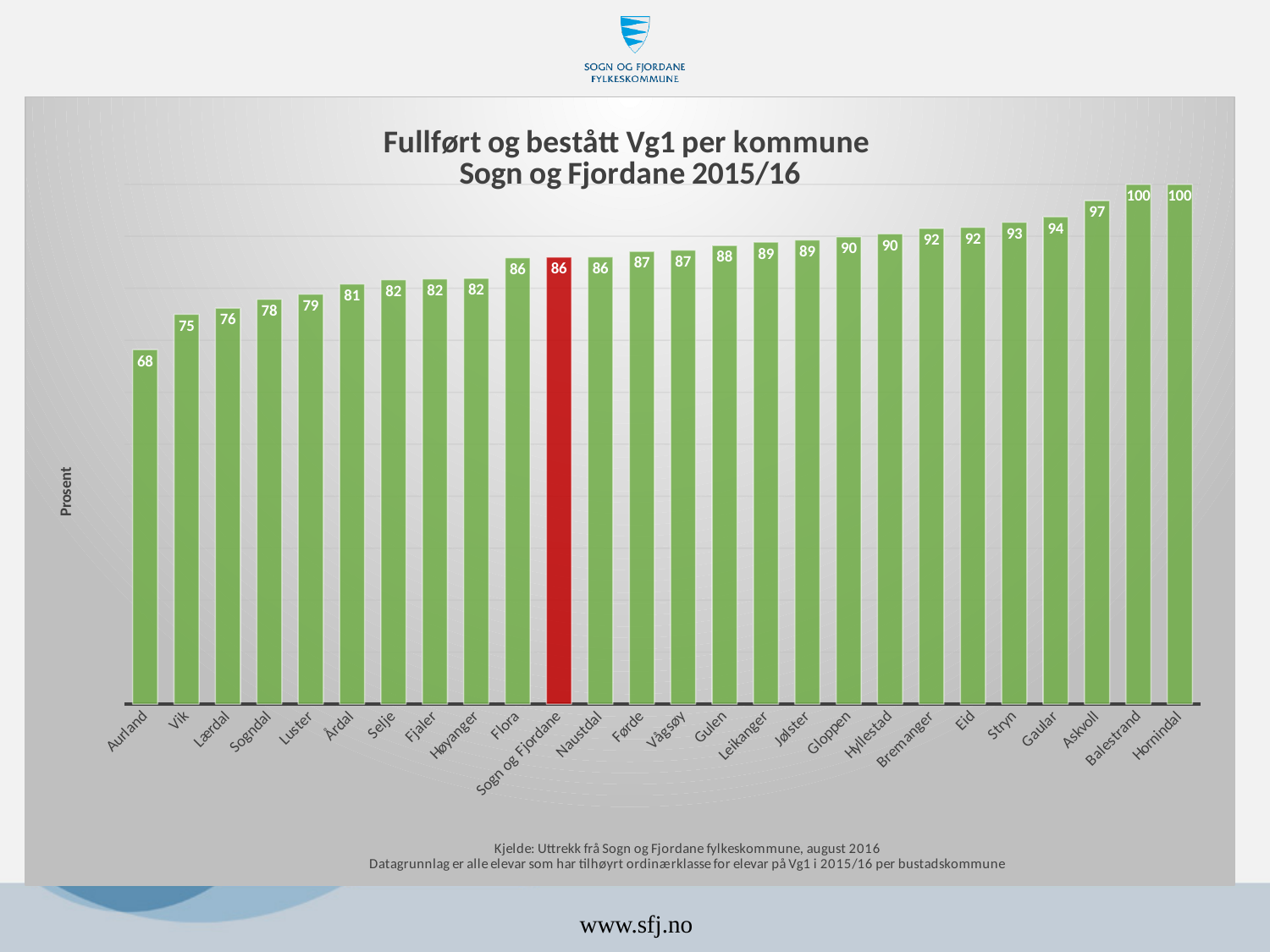
What is the value for Sogn og Fjordane (the red bar)? 86 Do the values rise or fall from left to right along the x axis? Rise Which has a larger value, Luster or Gaular? Gaular What is the title of the chart? Fullført og bestått Vg1 per kommune Sogn og Fjordane 2015/16 Which kommune has the lowest value? Aurland What is the value for Aurland? 68 What is the value for Askvoll? 97 What is the difference between the values for Stryn and Vik? 18 What is the difference between the values for Hornindal and Aurland? 32 How many bars are shown in the chart? 26 What is the value for Gloppen? 90 What kind of chart is shown on the slide? Bar chart